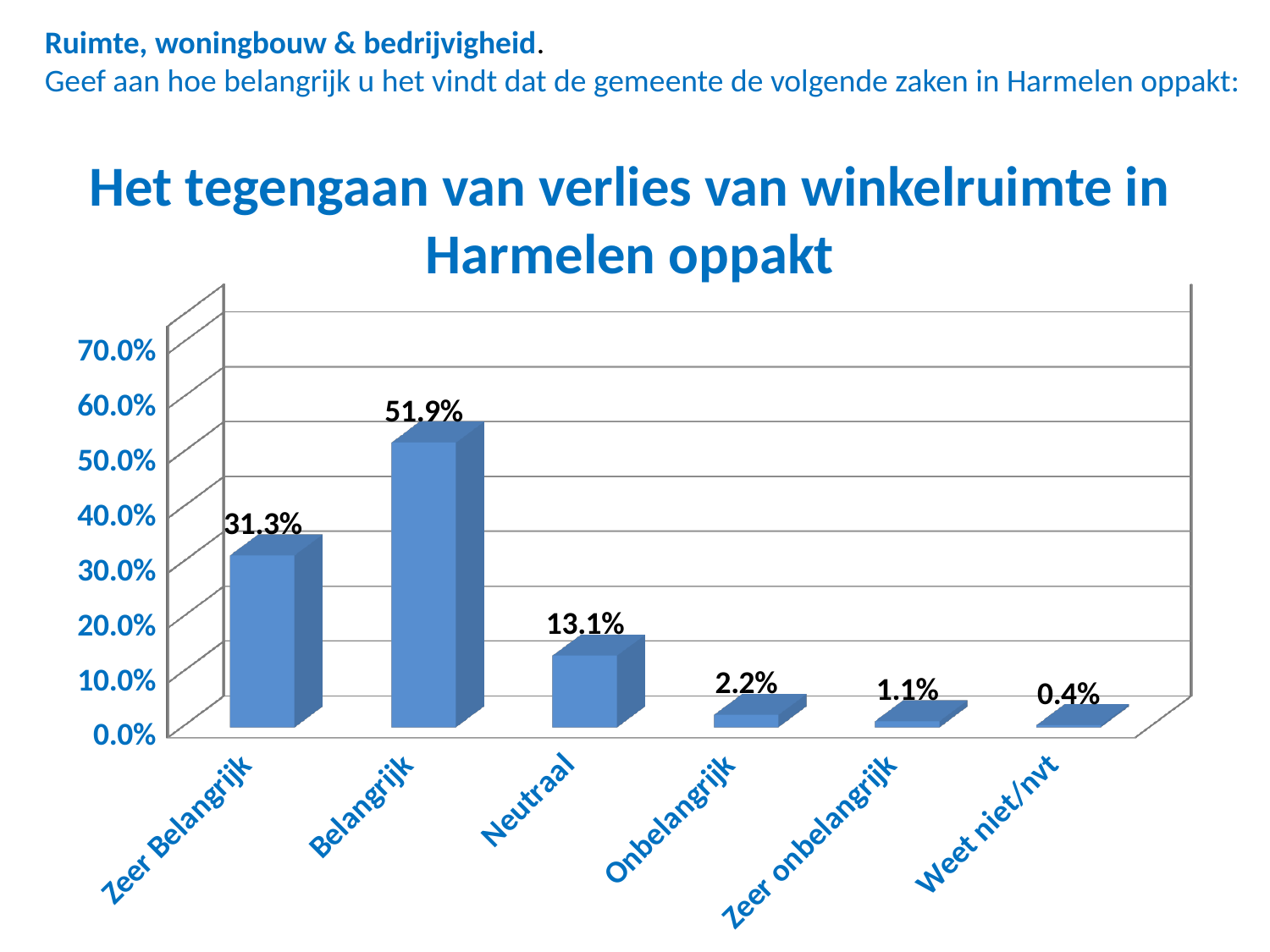
What kind of chart is shown? bar chart Which category has the lowest value? Weet niet/nvt What is the title of the chart? Het tegengaan van verlies van winkelruimte in Harmelen oppakt How many categories are shown on the x axis? 6 Which category has the highest value? Belangrijk Is the value for Belangrijk greater or less than 50.0%? greater What is the value for Neutraal? 13.1% What is the value for Belangrijk? 51.9% What is the value for Weet niet/nvt? 0.4% What is the value for Zeer Belangrijk? 31.3% What is the difference between the values for Belangrijk and Zeer Belangrijk? 20.6% Which is larger, the value for Onbelangrijk or the value for Zeer onbelangrijk? Onbelangrijk